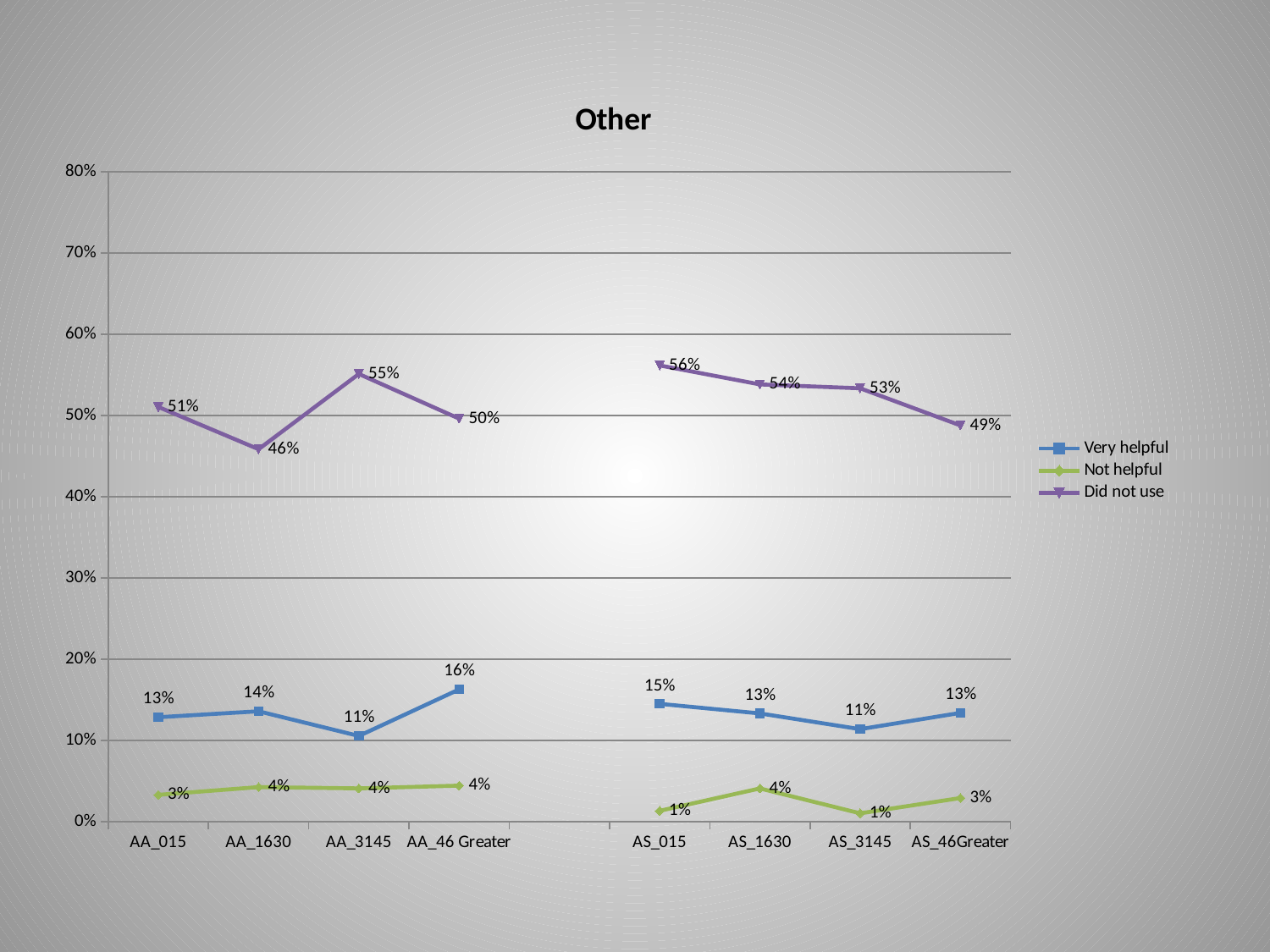
What kind of chart is this? line chart Which category has the lowest "Very helpful" value among the AA categories? AA_3145 What is the value for "Not helpful" at AS_3145? 1% Which is larger: the "Very helpful" value at AA_46 Greater or at AS_46Greater? AA_46 Greater How many series does the legend list? 3 What is the difference between the "Did not use" values at AA_3145 and AA_1630? 9% What is the value for "Very helpful" at AS_015? 15% How many categories are shown on the x axis? 8 Is the "Did not use" value at AS_46Greater greater or less than 40%? greater Which category has the highest "Did not use" value? AS_015 What is the value for "Did not use" at AA_3145? 55% Does the "Did not use" series rise or fall across the AS categories from AS_015 to AS_46Greater? fall